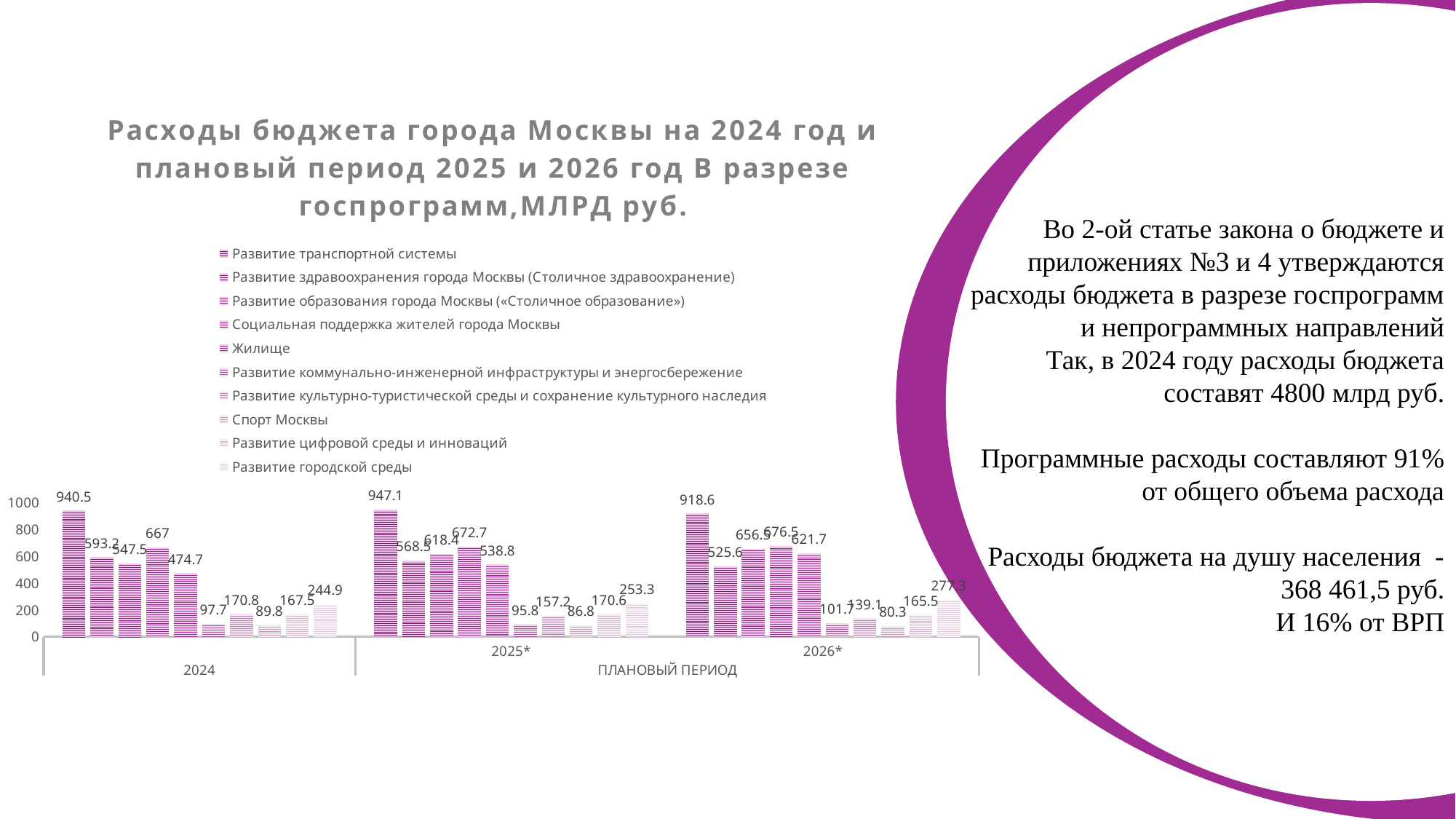
What is the value for «Развитие городской среды» in 2026*? 277.3 What is the value for «Социальная поддержка жителей города Москвы» in 2025*? 672.7 Which series has the lowest value in 2024? Спорт Москвы Does the value for «Жилище» rise or fall from 2024 to 2026*? rise Which is larger: «Развитие образования города Москвы» in 2024 or in 2026*? 2026* What is the title of the chart? Расходы бюджета города Москвы на 2024 год и плановый период 2025 и 2026 год В разрезе госпрограмм,МЛРД руб. How many series does the legend list? 10 What type of chart is shown on the slide? bar chart Which series has the highest value in 2026*? Развитие транспортной системы What is the difference between the «Развитие транспортной системы» values for 2025* and 2024? 6.6 How many year categories are shown on the x axis? 3 What is the value for «Развитие транспортной системы» in 2024? 940.5